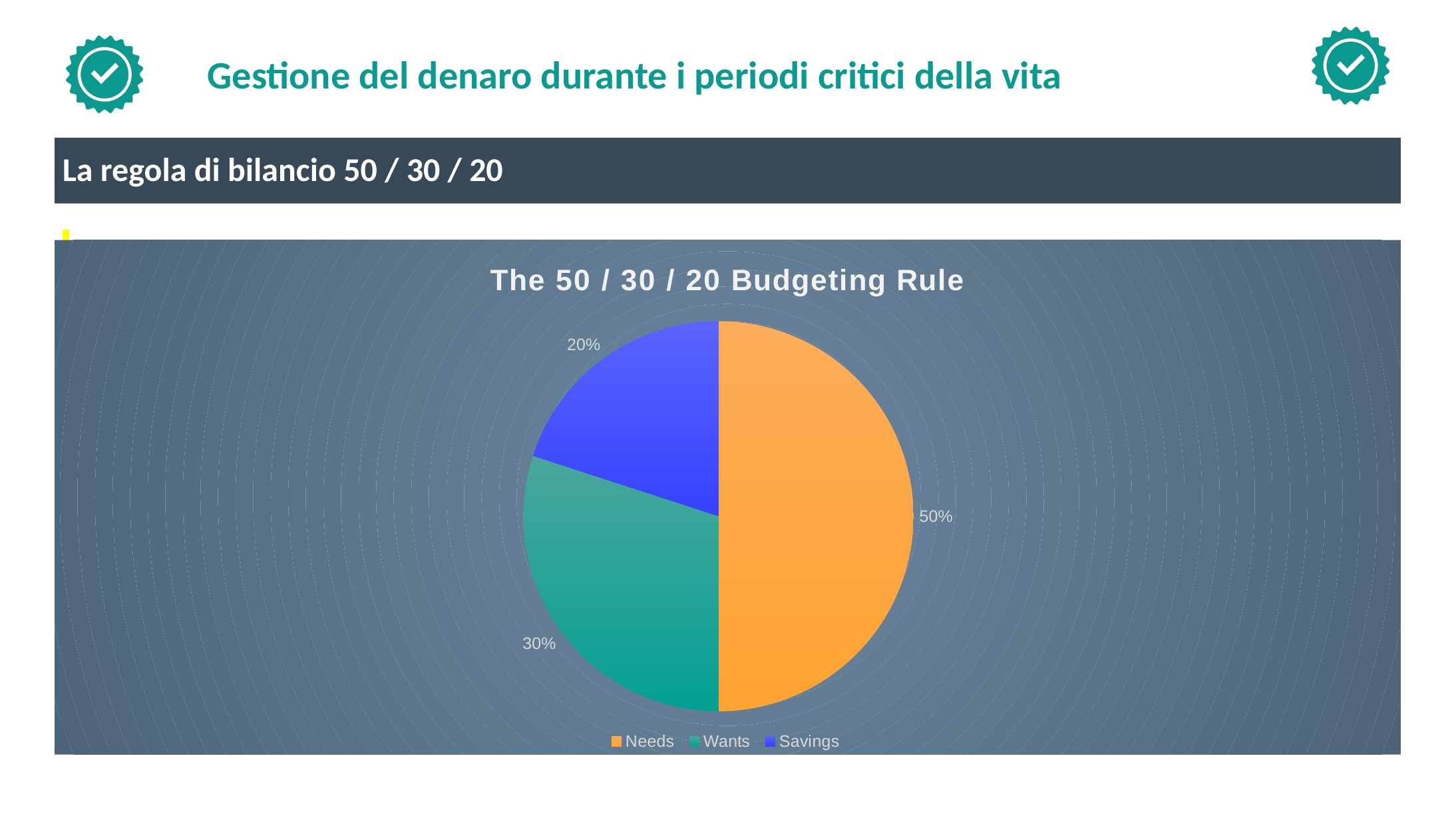
What is the difference in percentage points between Wants and Savings? 10 What type of chart is shown on the slide? pie chart What is the difference in percentage points between Needs and Savings? 30 What is the title of the chart? The 50 / 30 / 20 Budgeting Rule Which colour represents Savings in the legend? blue How many slices does the pie chart have? 3 What percentage of the pie is Wants? 30% Which category has the smallest share of the pie? Savings What percentage of the pie is Needs? 50% What percentage of the pie is Savings? 20% Which category has the largest share of the pie? Needs Which is larger, the share for Wants or the share for Savings? Wants